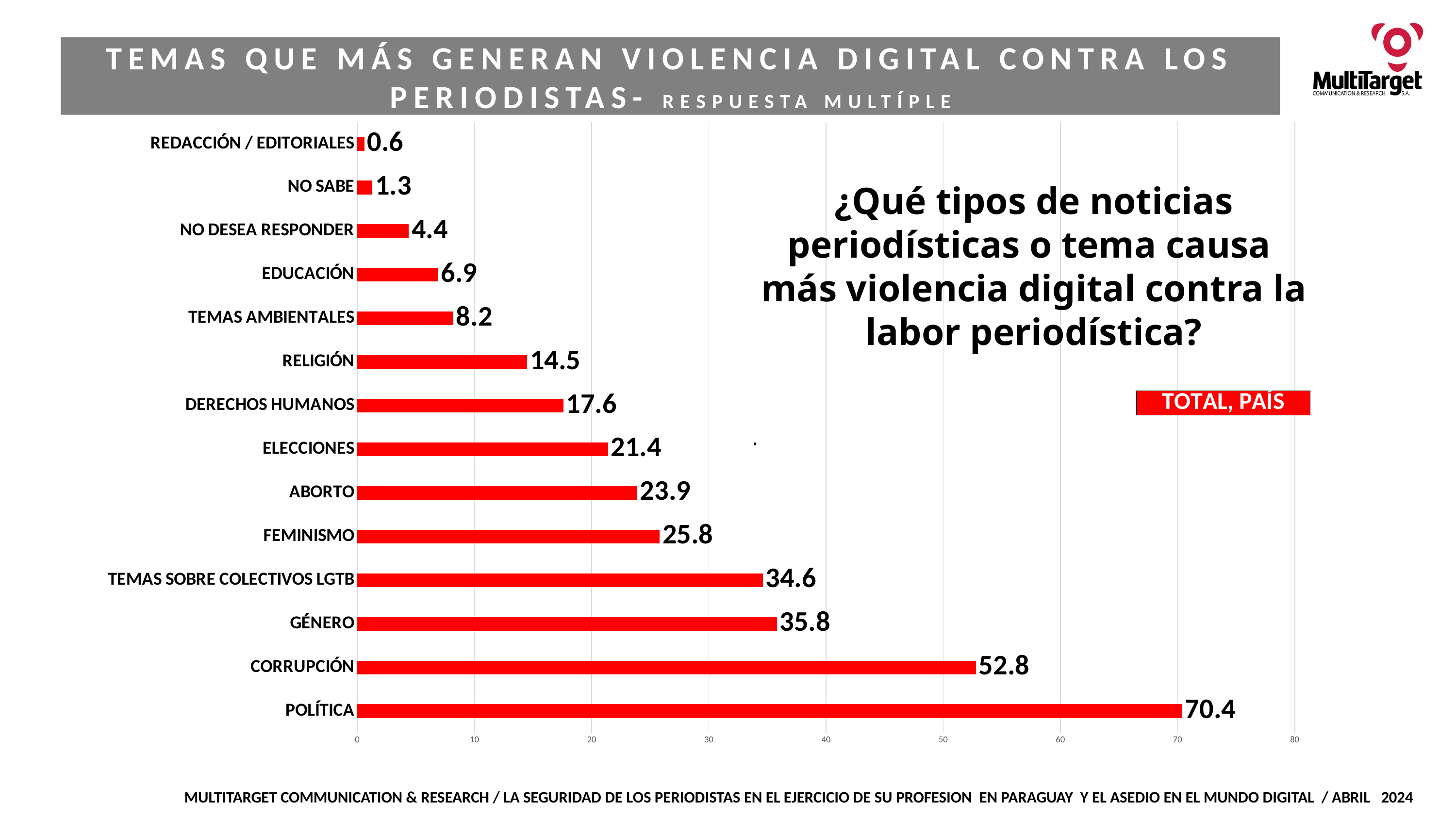
Is the value for FEMINISMO greater or less than 30? less What is the value for POLÍTICA? 70.4 What kind of chart is shown on the slide? bar chart What is the difference between the values for POLÍTICA and CORRUPCIÓN? 17.6 What is the value for RELIGIÓN? 14.5 What is the value for TEMAS SOBRE COLECTIVOS LGTB? 34.6 What does the legend label in the red box say? TOTAL, PAÍS How many categories are shown in the chart? 14 Which category has the lowest value? REDACCIÓN / EDITORIALES Which is larger, the value for ABORTO or the value for ELECCIONES? ABORTO What is the value for CORRUPCIÓN? 52.8 Which category has the highest value? POLÍTICA